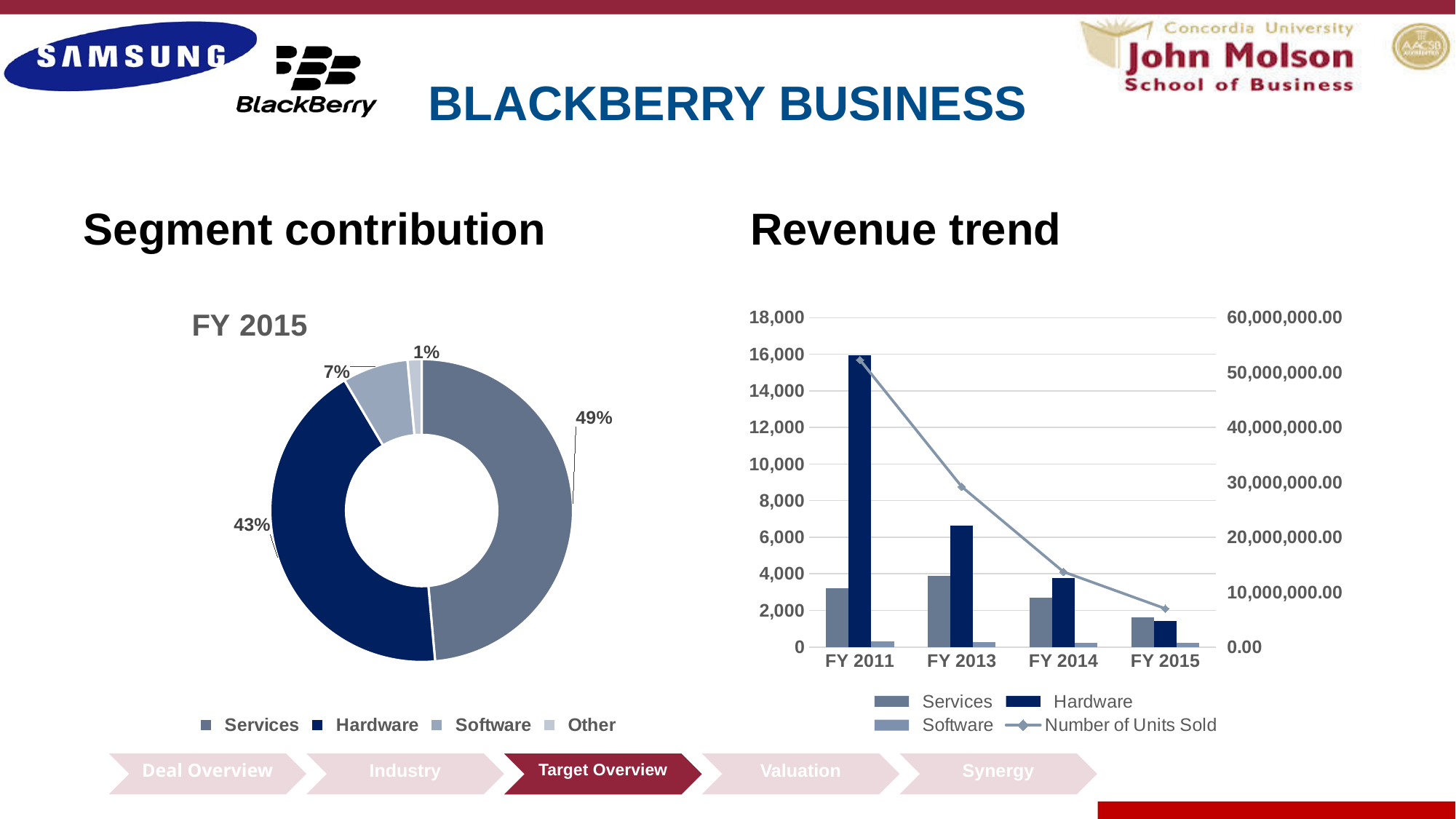
In the Segment contribution chart, how many segments are shown? 4 In the Revenue trend chart, which fiscal year has the highest Hardware bar? FY 2011 In the Revenue trend chart, is the Hardware value for FY 2011 greater or less than 14,000? greater In the Segment contribution chart, which segment has the smallest share? Other In the Revenue trend chart, how many series does the legend list? 4 In the Segment contribution chart, what share does Services account for? 49% In the Segment contribution chart, which segment has the largest share? Services In the Segment contribution chart, what share does Software account for? 7% In the Segment contribution chart, what share does Hardware account for? 43% What kind of chart is the Segment contribution chart? Pie (donut) chart In the Revenue trend chart, does the Hardware revenue rise or fall from FY 2011 to FY 2015? fall In the Segment contribution chart, how many percentage points larger is the Services share than the Hardware share? 6 percentage points